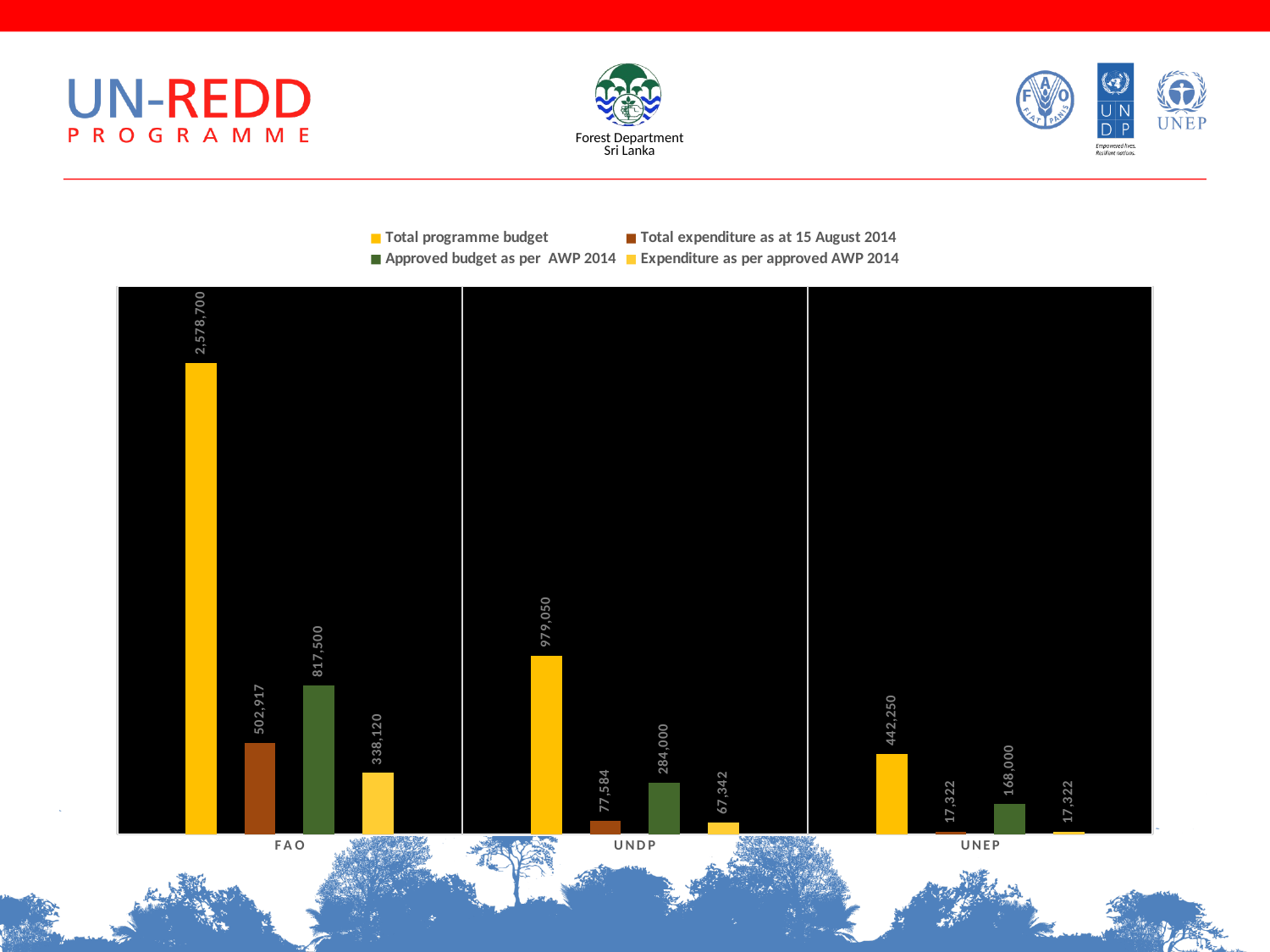
What is the difference between the Approved budget as per AWP 2014 and the Expenditure as per approved AWP 2014 for UNEP? 150,678 What is the difference between the Total programme budget for FAO and for UNDP? 1,599,650 What is the Total programme budget for FAO? 2,578,700 How many series does the chart legend list? 4 What kind of chart is shown on the slide? Bar chart What is the Total expenditure as at 15 August 2014 for UNEP? 17,322 Which is larger for UNDP: the Total expenditure as at 15 August 2014 or the Expenditure as per approved AWP 2014? Total expenditure as at 15 August 2014 Which agency has the highest Total programme budget? FAO How many agencies are shown on the x axis of the chart? 3 What is the Approved budget as per AWP 2014 for UNDP? 284,000 Which agency has the lowest Approved budget as per AWP 2014? UNEP What is the Expenditure as per approved AWP 2014 for FAO? 338,120